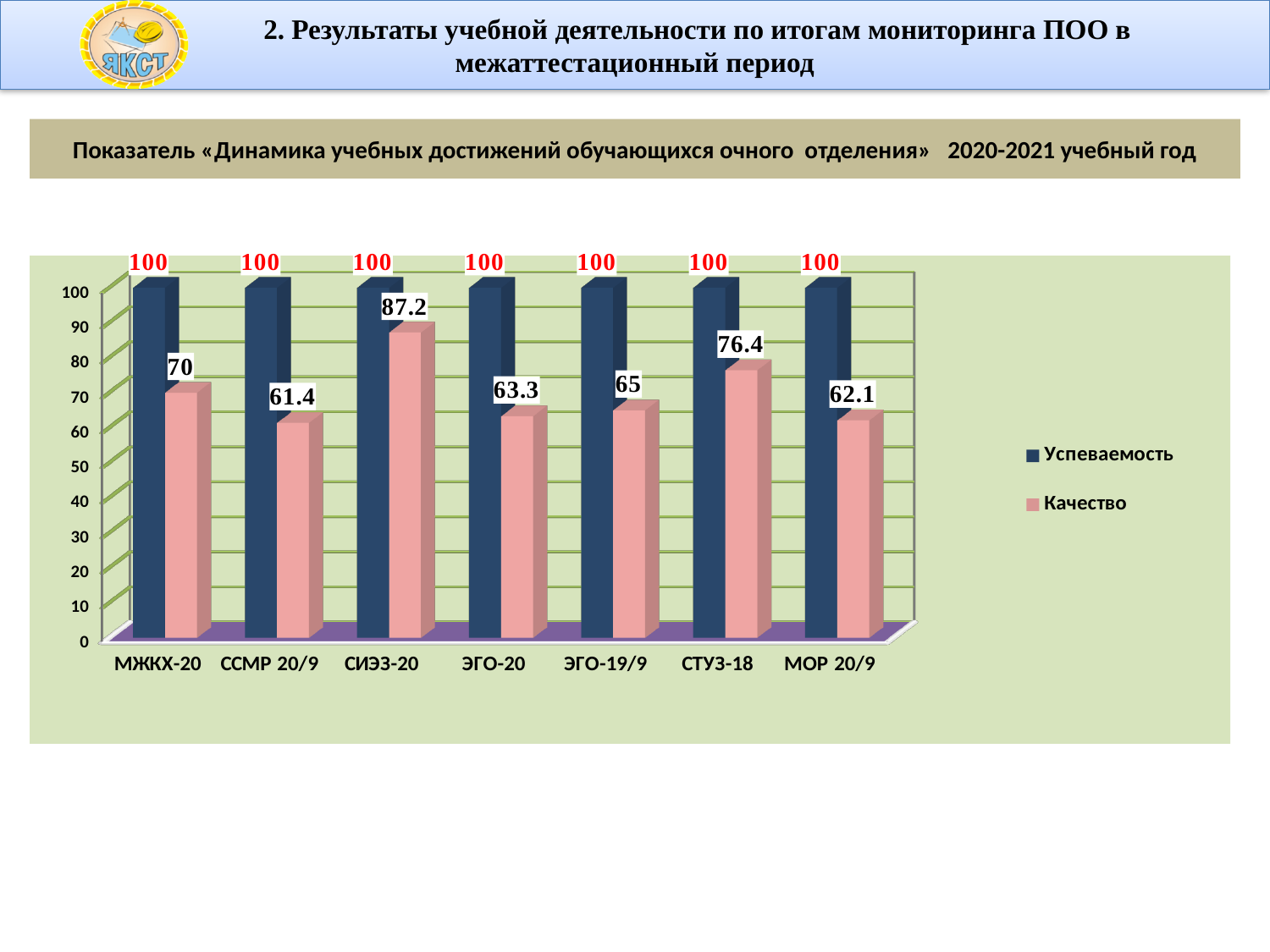
What is the Качество value for СИЭЗ-20? 87.2 Which category has the lowest Качество value? ССМР 20/9 Which series is shown in pink in the legend? Качество What is the Успеваемость value for ЭГО-20? 100 Which has a larger Качество value, ЭГО-19/9 or ЭГО-20? ЭГО-19/9 What is the difference between the Успеваемость and Качество values for ССМР 20/9? 38.6 What kind of chart is shown on the slide? bar chart Which category has the highest Качество value? СИЭЗ-20 What is the difference between the Качество values for СТУЗ-18 and МОР 20/9? 14.3 How many series does the legend list? 2 How many categories are shown on the x axis? 7 What is the Качество value for МЖКХ-20? 70